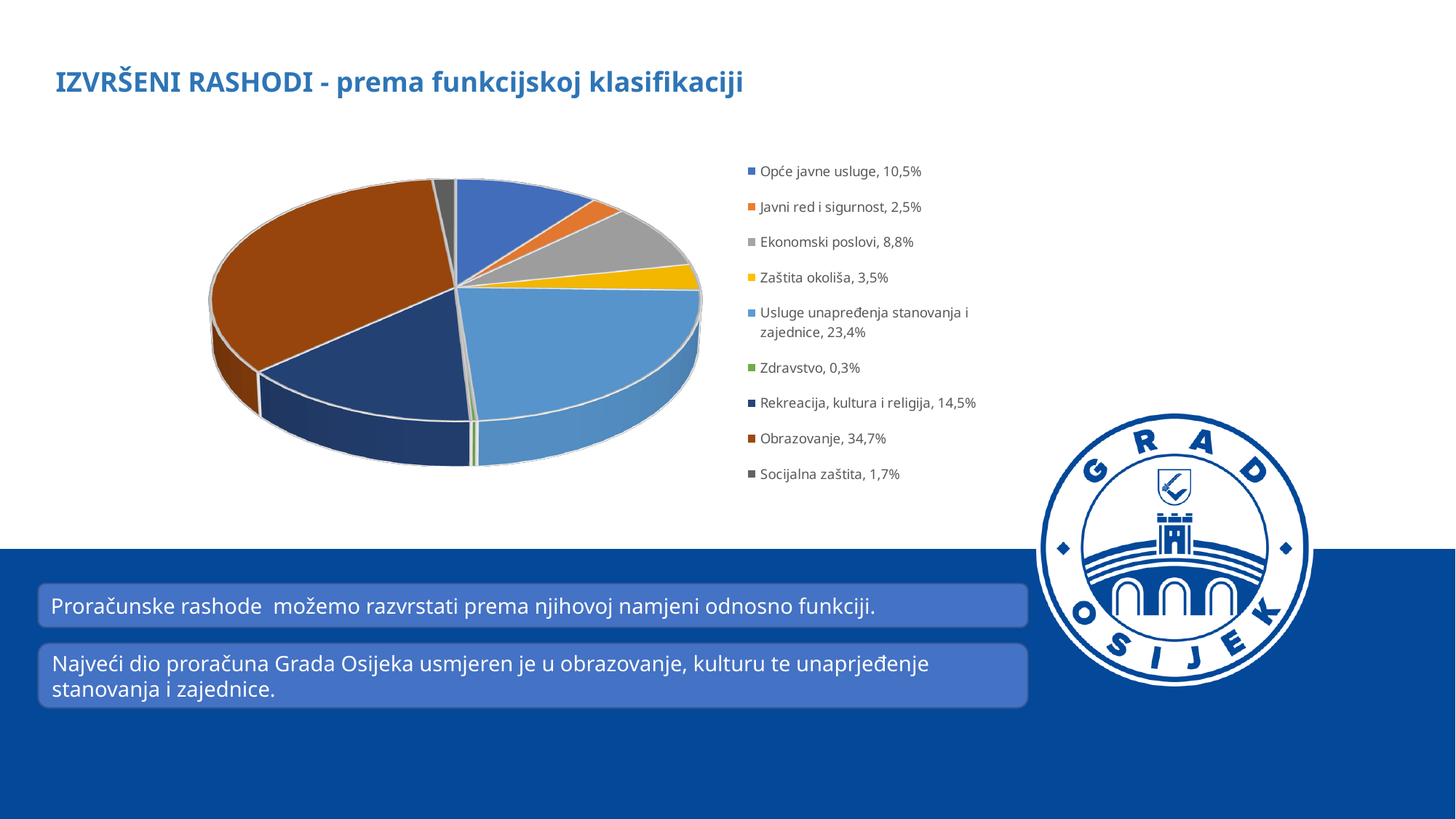
How many categories does the pie chart show? 9 What share of the pie does Usluge unapređenja stanovanja i zajednice represent? 23,4% Which category has the largest share of the pie? Obrazovanje Which category has the smallest share of the pie? Zdravstvo What is the difference in percentage points between Obrazovanje and Usluge unapređenja stanovanja i zajednice? 11,3 What is the combined share of Javni red i sigurnost and Socijalna zaštita? 4,2% What kind of chart is shown on the slide? Pie chart What is the value shown for Rekreacija, kultura i religija? 14,5% What is the title of the chart on the slide? IZVRŠENI RASHODI - prema funkcijskoj klasifikaciji What is the value shown for Zaštita okoliša? 3,5% Which is larger, Opće javne usluge or Ekonomski poslovi? Opće javne usluge What share of the pie does Obrazovanje represent? 34,7%